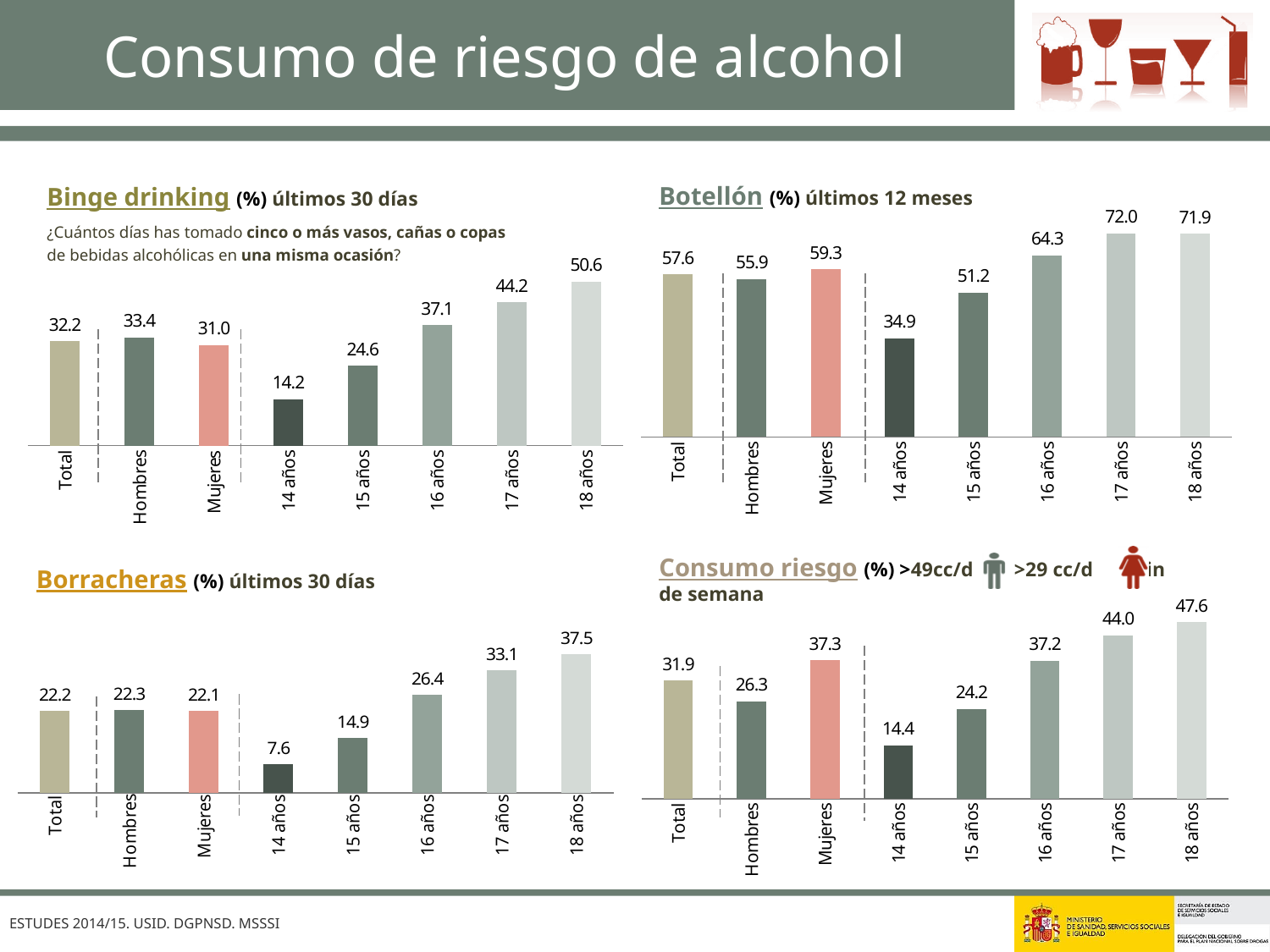
In the Botellón chart, what is the value for Mujeres? 59.3 In the Binge drinking chart, what is the difference between the values for 18 años and 14 años? 36.4 In the Borracheras chart, do the values rise or fall from 14 años to 18 años? rise In the Consumo riesgo chart, what is the value for Total? 31.9 In the Borracheras chart, how many categories are shown on the x axis? 8 In the Consumo riesgo chart, what is the difference between the values for Mujeres and Hombres? 11.0 In the Botellón chart, which category has the highest value? 17 años In the Botellón chart, which is larger, the value for Hombres or the value for Mujeres? Mujeres In the Borracheras chart, what is the value for 15 años? 14.9 In the Binge drinking chart, what is the value for Hombres? 33.4 What kind of chart is the Botellón chart? bar chart In the Binge drinking chart, which category has the lowest value? 14 años